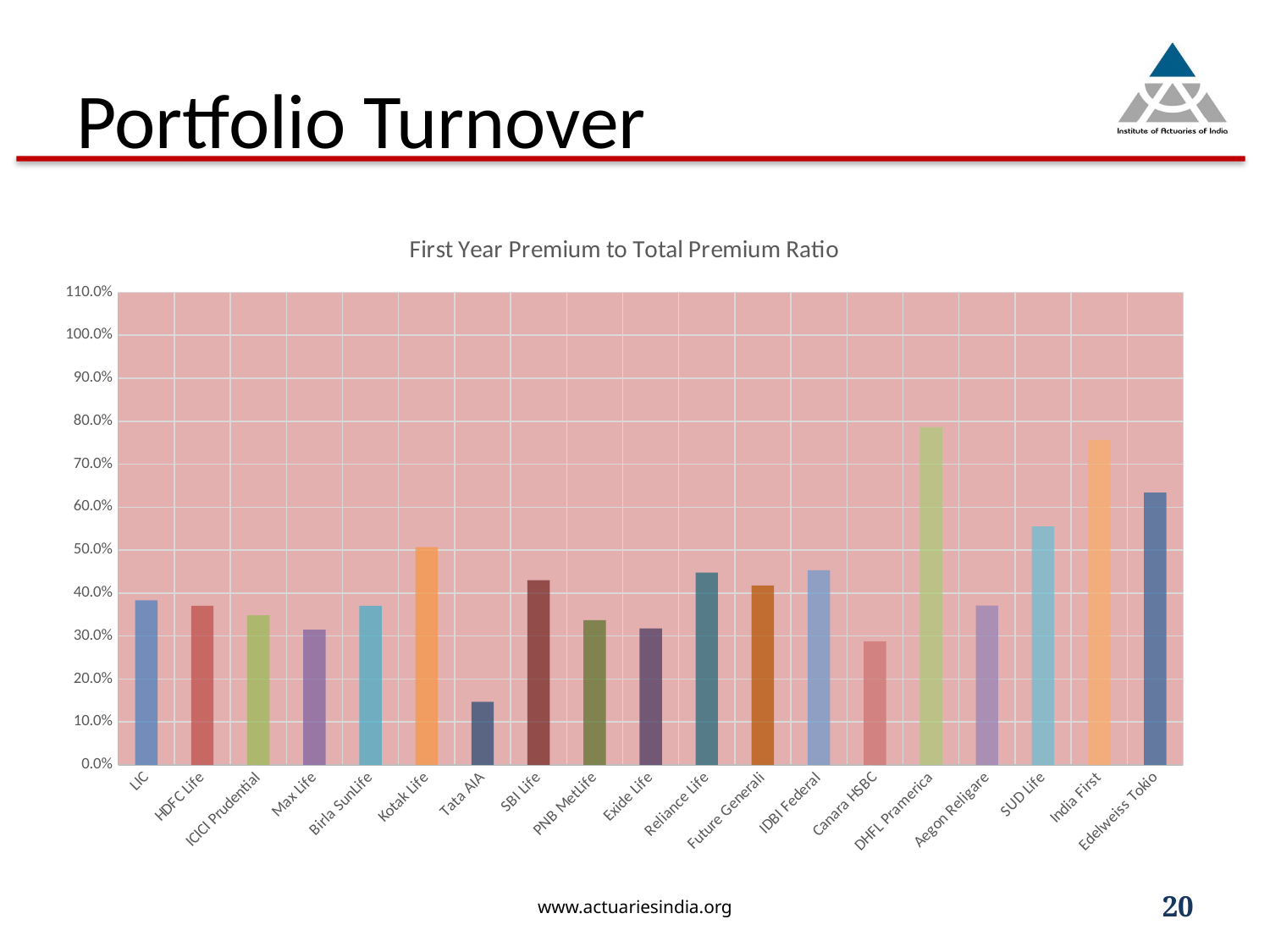
What type of chart is shown on the slide? bar chart Is the value for SUD Life greater or less than 50.0%? greater Is the value for DHFL Pramerica greater or less than 70.0%? greater What is the highest value shown on the y axis? 110.0% Which insurer has the lowest First Year Premium to Total Premium Ratio? Tata AIA Is the value for Edelweiss Tokio greater or less than 60.0%? greater What is the title of the chart? First Year Premium to Total Premium Ratio How many insurers (categories) are plotted on the x axis? 19 Which is larger, the value for Edelweiss Tokio or the value for SUD Life? Edelweiss Tokio Which is larger, the value for Kotak Life or the value for LIC? Kotak Life